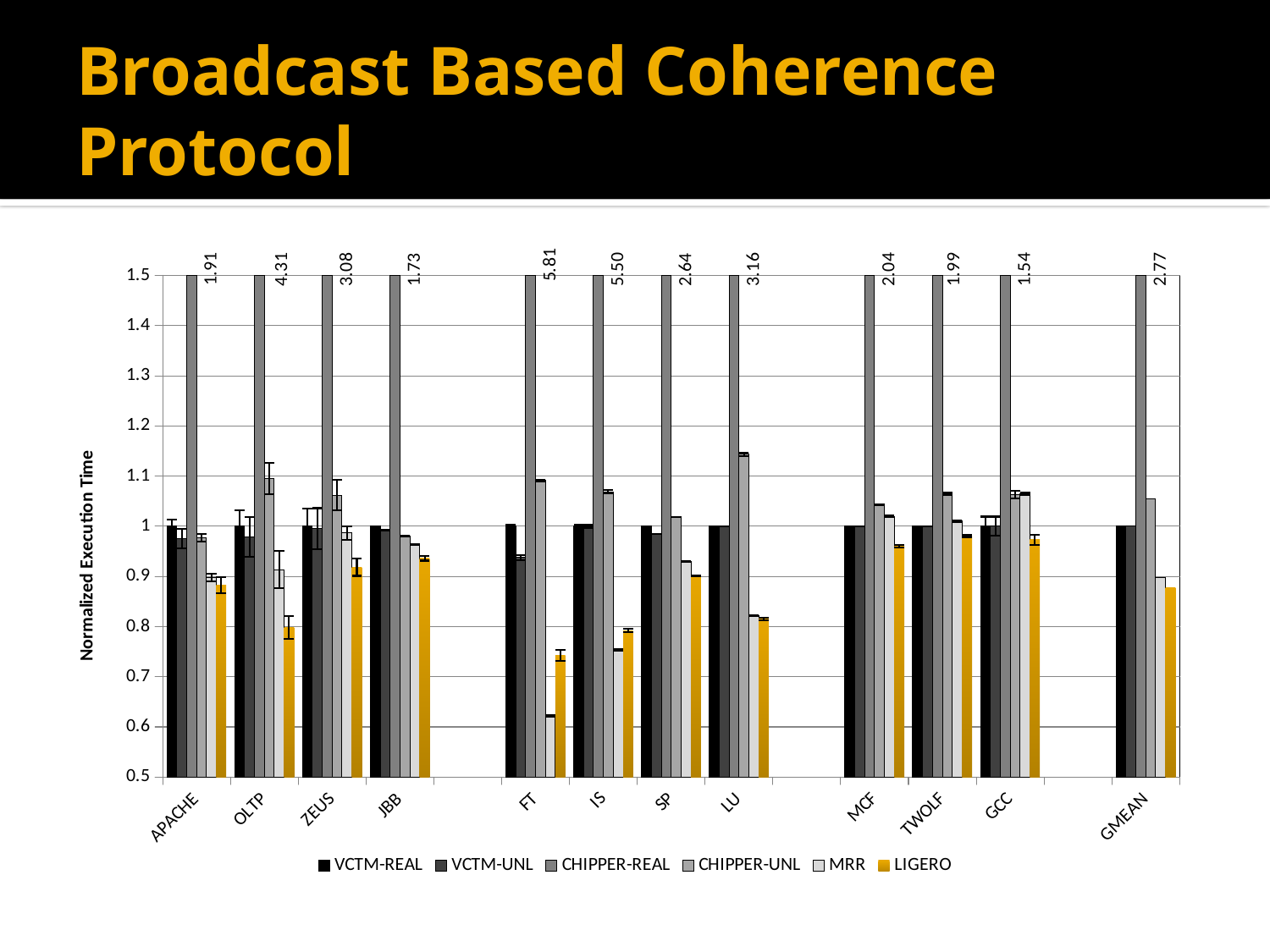
Which category has the lowest labeled CHIPPER-REAL value? GCC Is the MRR value for FT greater or less than 0.7? less What is the labeled value of the CHIPPER-REAL bar for FT? 5.81 What kind of chart is shown on the slide? bar chart Is the CHIPPER-UNL value for LU greater or less than 1.1? greater How many series does the legend list? 6 Which category has the highest labeled CHIPPER-REAL value? FT Which has the larger labeled CHIPPER-REAL value, OLTP or ZEUS? OLTP Is the LIGERO value for FT greater or less than 0.8? less What is the difference between the labeled CHIPPER-REAL values for FT and IS? 0.31 How many categories are shown on the x axis? 12 What is the labeled value of the CHIPPER-REAL bar for GMEAN? 2.77